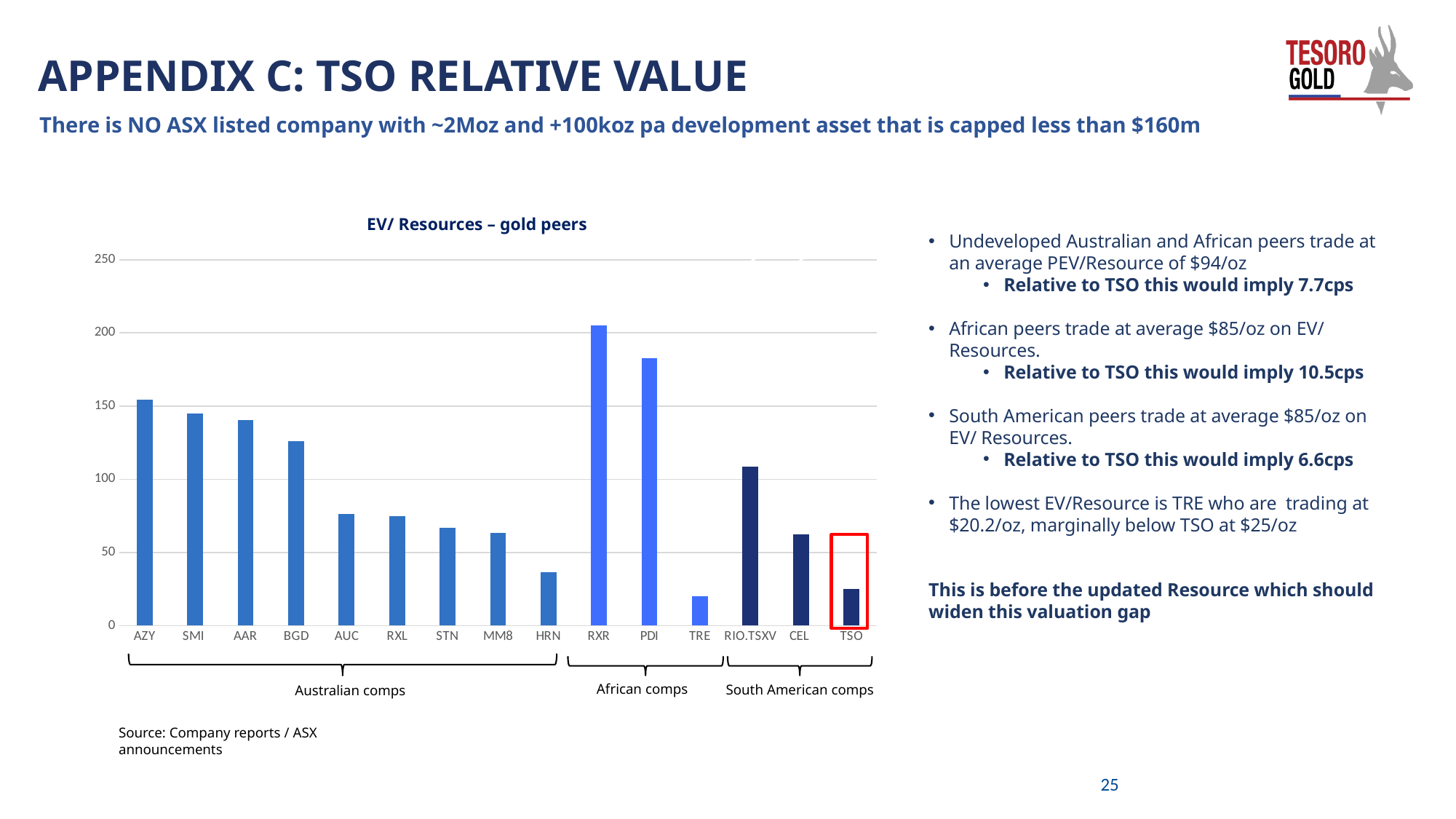
Do the values for the Australian comps rise or fall from AZY to HRN? Fall Is the value for HRN greater or less than 50? less Which has the larger value, PDI or RIO.TSXV? PDI Is the value for PDI greater or less than 200? less Which company has the highest bar on the chart? RXR Which has the larger value, RXR or PDI? RXR What is the title of the chart? EV/ Resources – gold peers What kind of chart is shown on the slide? Bar chart How many companies are plotted on the chart? 15 Is the value for TSO greater or less than 50? less Which company has the lowest bar on the chart? TRE